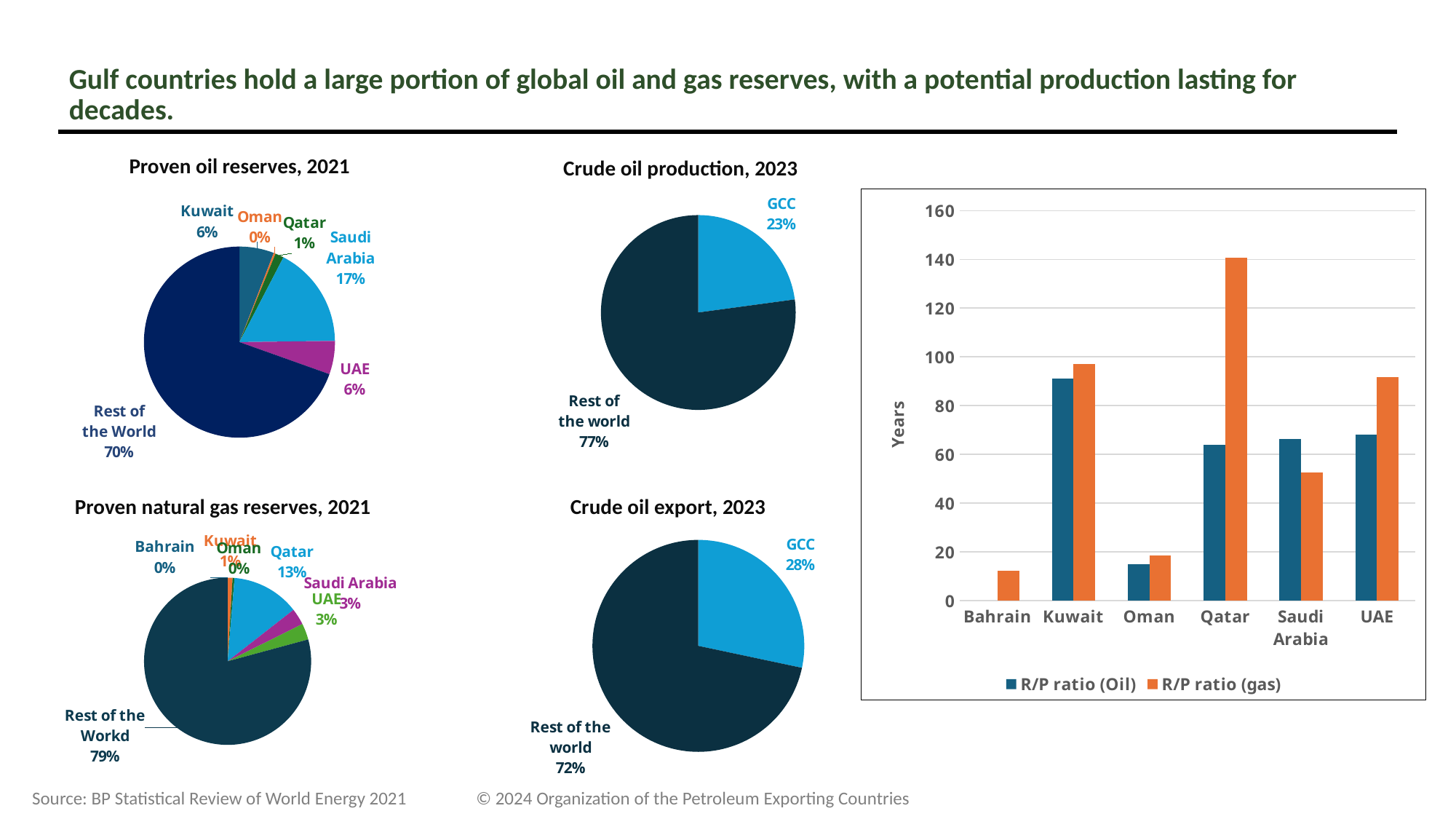
How many series does the legend of the bar chart on the right list? 2 How many countries are shown on the x axis of the bar chart on the right? 6 In the bar chart on the right, is the R/P ratio (Oil) value for Kuwait greater or less than 80? greater In the 'Crude oil production, 2023' pie chart, what share is shown for GCC? 23% In the 'Proven natural gas reserves, 2021' pie chart, which has the larger share, Qatar or Saudi Arabia? Qatar In the 'Proven oil reserves, 2021' pie chart, which Gulf country has the largest slice? Saudi Arabia In the 'Crude oil export, 2023' pie chart, what share is shown for Rest of the world? 72% What is the label on the vertical axis of the bar chart on the right? Years In the 'Proven oil reserves, 2021' pie chart, how many percentage points larger is Saudi Arabia's share than Kuwait's? 11 percentage points In the 'Proven natural gas reserves, 2021' pie chart, what share is shown for Qatar? 13% In the 'Proven oil reserves, 2021' pie chart, what share is shown for Saudi Arabia? 17% In the bar chart on the right, is the R/P ratio (gas) value for Qatar greater or less than 120? greater